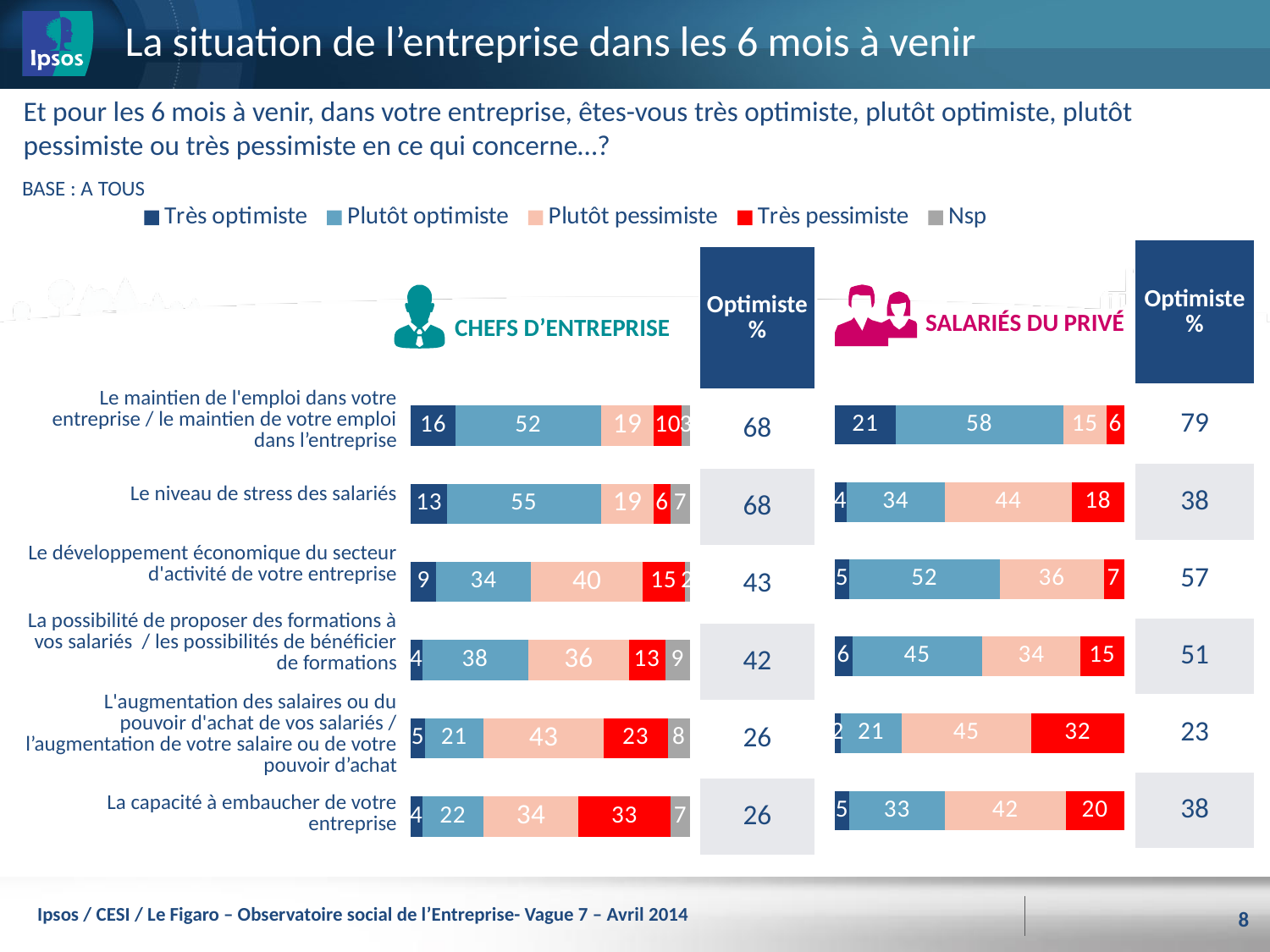
In the SALARIÉS DU PRIVÉ chart, what is the 'Plutôt optimiste' value for 'Le maintien de l'emploi'? 58 Is the 'Optimiste %' for 'Le maintien de l'emploi' higher for CHEFS D'ENTREPRISE or for SALARIÉS DU PRIVÉ? SALARIÉS DU PRIVÉ In the SALARIÉS DU PRIVÉ chart, what is the 'Très pessimiste' value for 'L'augmentation des salaires ou du pouvoir d'achat'? 32 In the CHEFS D'ENTREPRISE chart, what is the 'Plutôt optimiste' value for 'Le niveau de stress des salariés'? 55 Which colour represents 'Très pessimiste' in the legend? Red How many categories (items) are shown in the CHEFS D'ENTREPRISE chart? 6 In the SALARIÉS DU PRIVÉ chart, what is the difference between the 'Plutôt pessimiste' value for 'Le niveau de stress des salariés' and for 'Le développement économique du secteur d'activité'? 8 How many series does the legend list? 5 In the SALARIÉS DU PRIVÉ chart, which item has the lowest 'Optimiste %' total? L'augmentation des salaires ou du pouvoir d'achat In the CHEFS D'ENTREPRISE chart, which item has the highest 'Très pessimiste' value? La capacité à embaucher de votre entreprise What kind of chart is used on this slide for the CHEFS D'ENTREPRISE data? Stacked bar chart In the CHEFS D'ENTREPRISE chart, what is the 'Optimiste %' for 'Le développement économique du secteur d'activité de votre entreprise'? 43